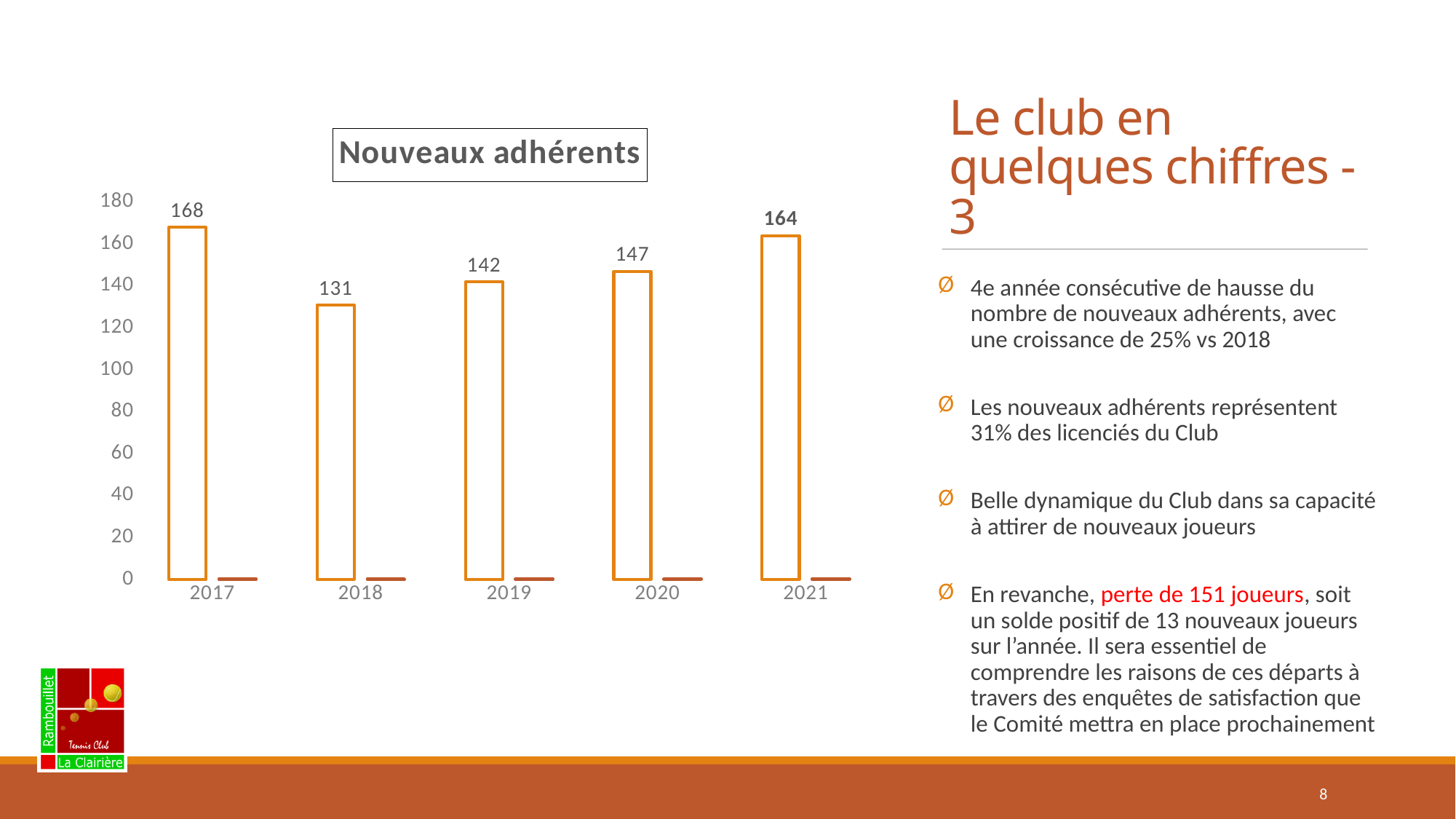
What is the value for 2021 in the Nouveaux adhérents chart? 164 How many years are shown on the x axis of the Nouveaux adhérents chart? 5 Which is larger in the Nouveaux adhérents chart, the value for 2019 or the value for 2020? 2020 What is the value for 2017 in the Nouveaux adhérents chart? 168 Do the values in the Nouveaux adhérents chart rise or fall from 2018 to 2021? rise What kind of chart is the Nouveaux adhérents chart? bar chart Which year has the lowest value in the Nouveaux adhérents chart? 2018 What is the difference between the values for 2017 and 2021 in the Nouveaux adhérents chart? 4 Which year has the highest value in the Nouveaux adhérents chart? 2017 What is the difference between the values for 2021 and 2018 in the Nouveaux adhérents chart? 33 Is the value for 2019 in the Nouveaux adhérents chart greater or less than 120? greater What is the value for 2018 in the Nouveaux adhérents chart? 131